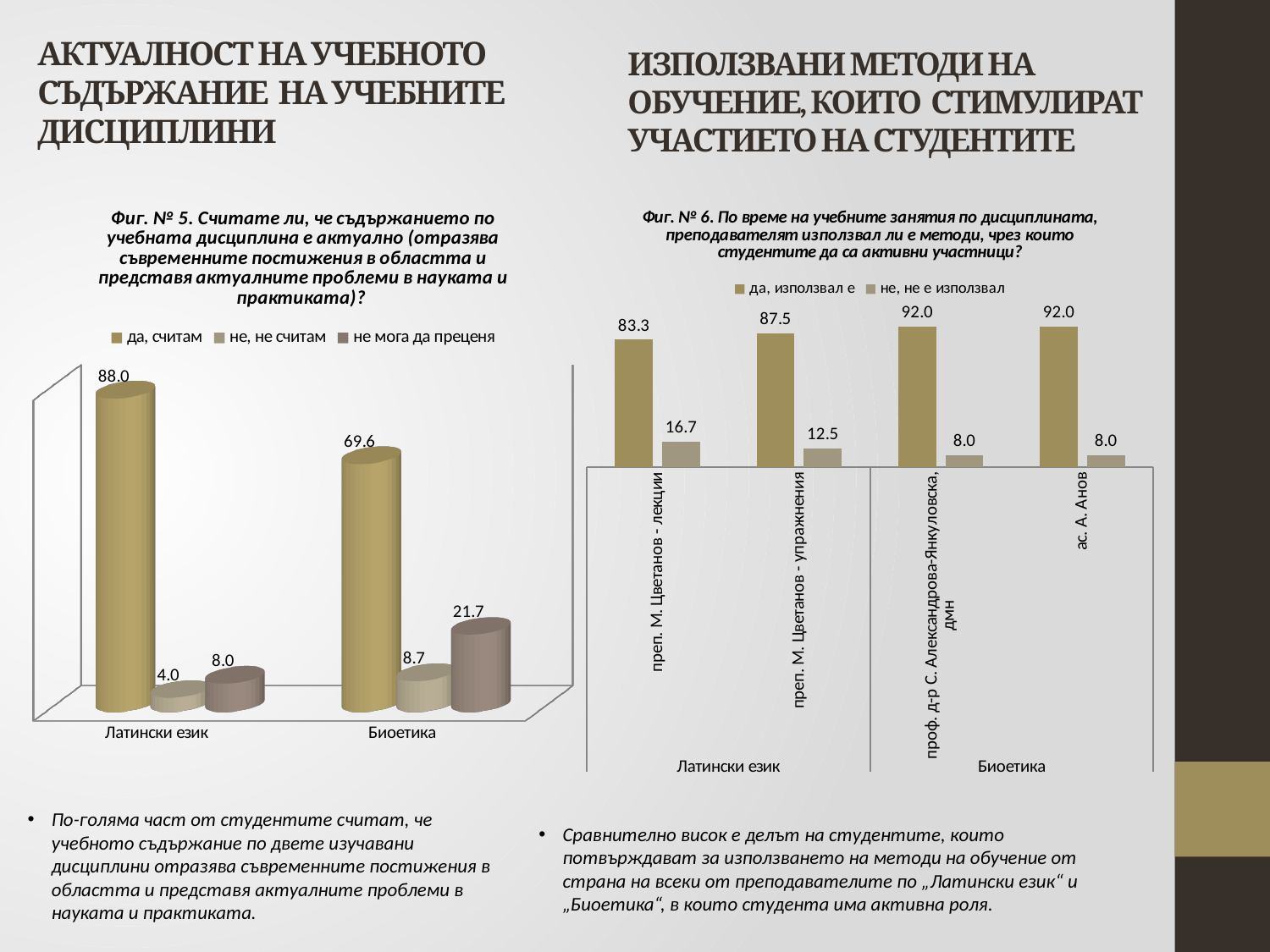
In the right chart (Фиг. № 6), what is the value for "не, не е използвал" for преп. М. Цветанов - упражнения? 12.5 In the left chart (Фиг. № 5), what is the value for "не мога да преценя" for Биоетика? 21.7 In the right chart (Фиг. № 6), how many teacher categories are shown? 4 In the left chart (Фиг. № 5), what is the value for "да, считам" for Латински език? 88.0 In the right chart (Фиг. № 6), how many series does the legend list? 2 In the left chart (Фиг. № 5), how many series does the legend list? 3 In the left chart (Фиг. № 5), which category has the higher value for "не, не считам"? Биоетика In the left chart (Фиг. № 5), what is the difference between the "да, считам" values for Латински език and Биоетика? 18.4 In the left chart (Фиг. № 5), what kind of chart is shown? Bar chart In the right chart (Фиг. № 6), what is the value for "да, използвал е" for преп. М. Цветанов - лекции? 83.3 In the right chart (Фиг. № 6), which teacher has the lowest value for "да, използвал е"? преп. М. Цветанов - лекции In the right chart (Фиг. № 6), what is the difference between the "не, не е използвал" values for преп. М. Цветанов - лекции and ас. А. Анов? 8.7